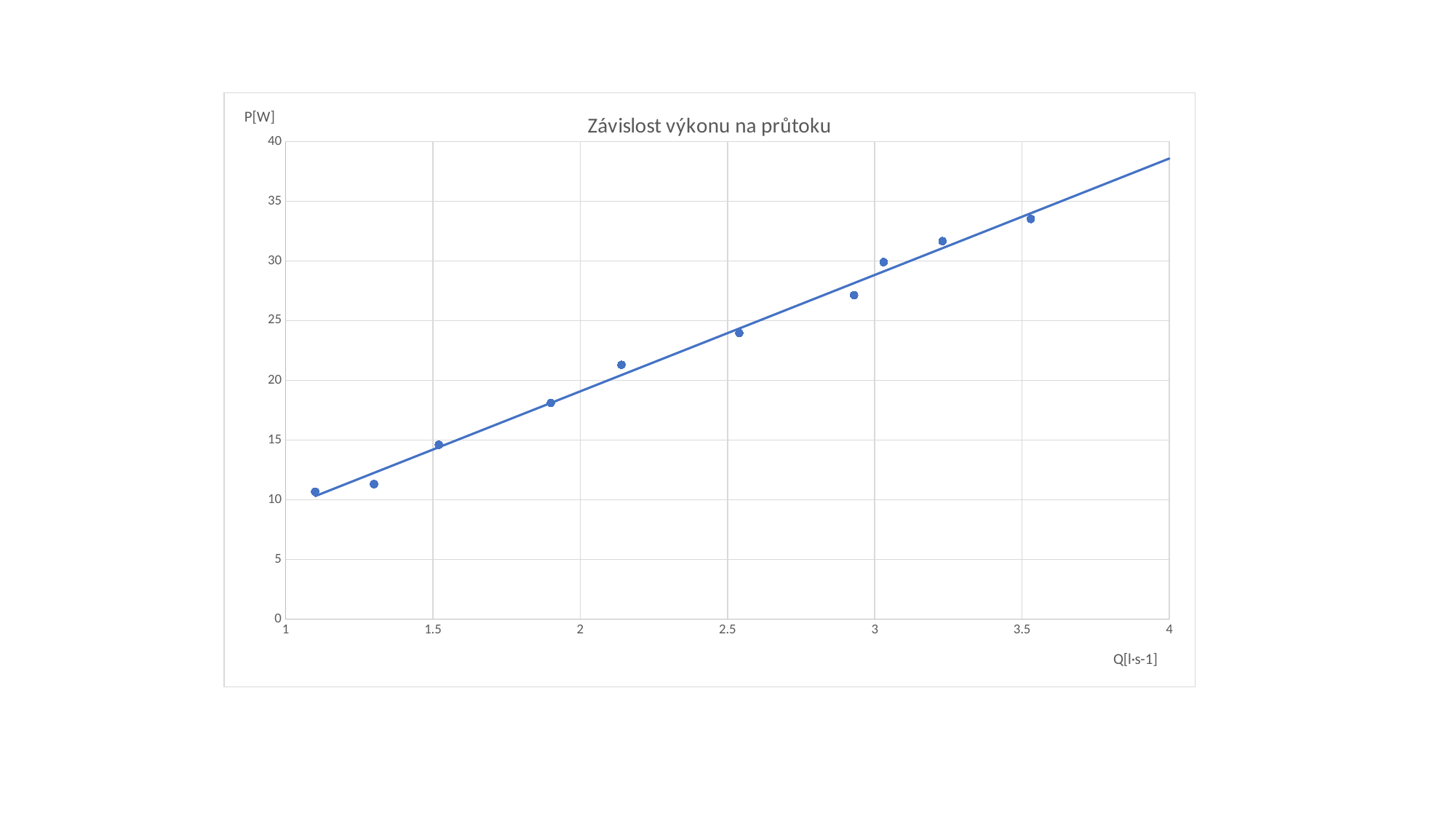
Is the value of P for the data point at about Q = 3.5 greater or less than 30? greater How many data points are plotted on the chart? 10 What is the maximum value shown on the vertical axis? 40 Do the values of P rise or fall as Q increases along the x axis? Rise Which data point has the highest value of P: the one at about Q = 1.1 or the one at about Q = 3.5? The one at about Q = 3.5 What is the label of the vertical axis? P[W] Is the value of P for the data point at about Q = 1.9 greater or less than 20? less Is the value of P for the data point at about Q = 2.9 greater or less than 25? greater What is the title of the chart? Závislost výkonu na průtoku What kind of chart is shown on the slide? Scatter chart